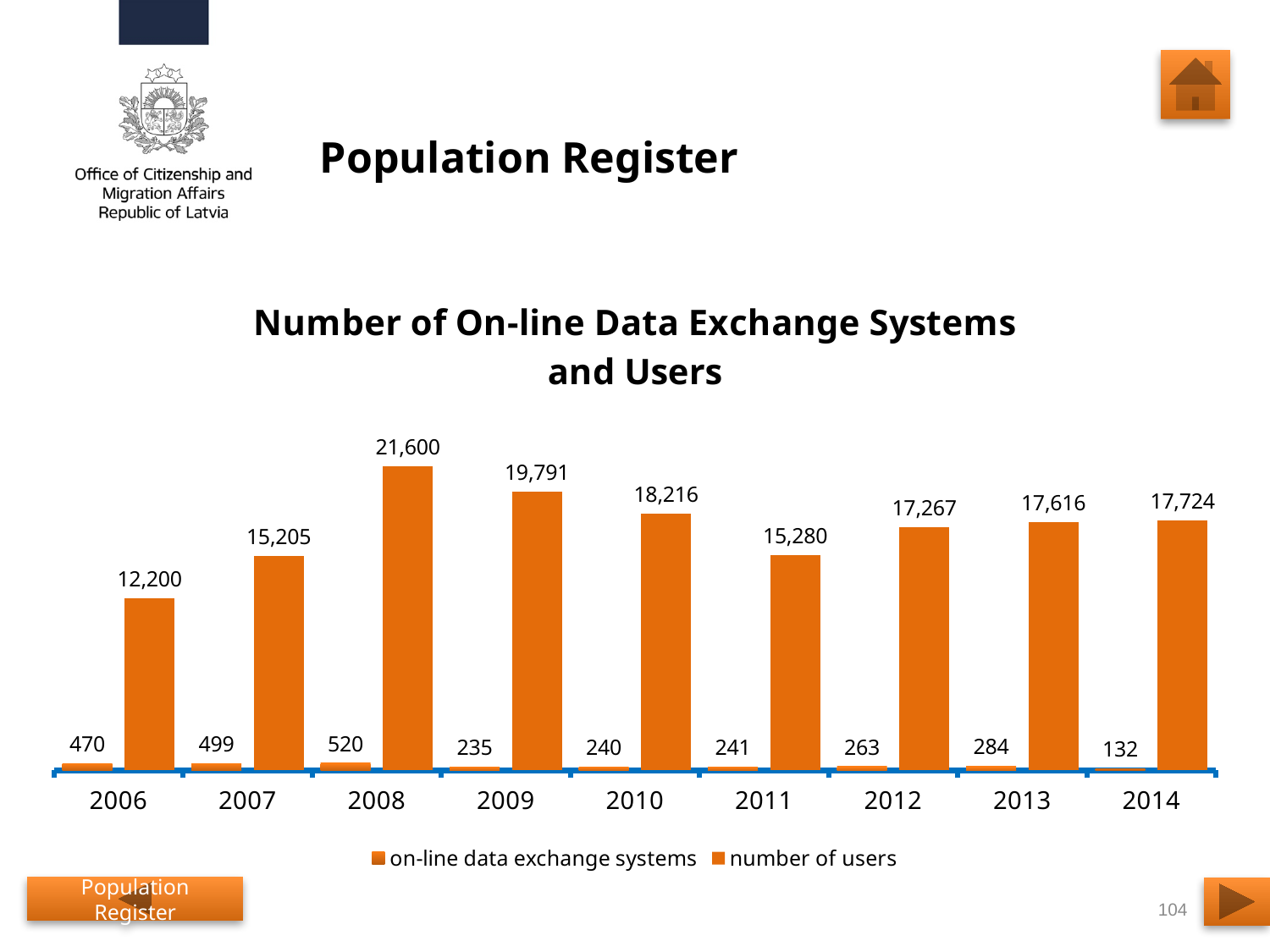
Which year has the highest number of on-line data exchange systems? 2008 Which year had more users, 2010 or 2013? 2010 What is the difference in the number of users between 2008 and 2009? 1,809 What is the number of users in 2011? 15,280 How many years are shown on the x axis? 9 Which year has the highest number of users? 2008 Which year has the lowest number of on-line data exchange systems? 2014 What type of chart is shown on the slide? Bar chart How many series does the legend list? 2 What is the difference in the number of on-line data exchange systems between 2007 and 2014? 367 What is the number of users in 2008? 21,600 How many on-line data exchange systems were there in 2014? 132